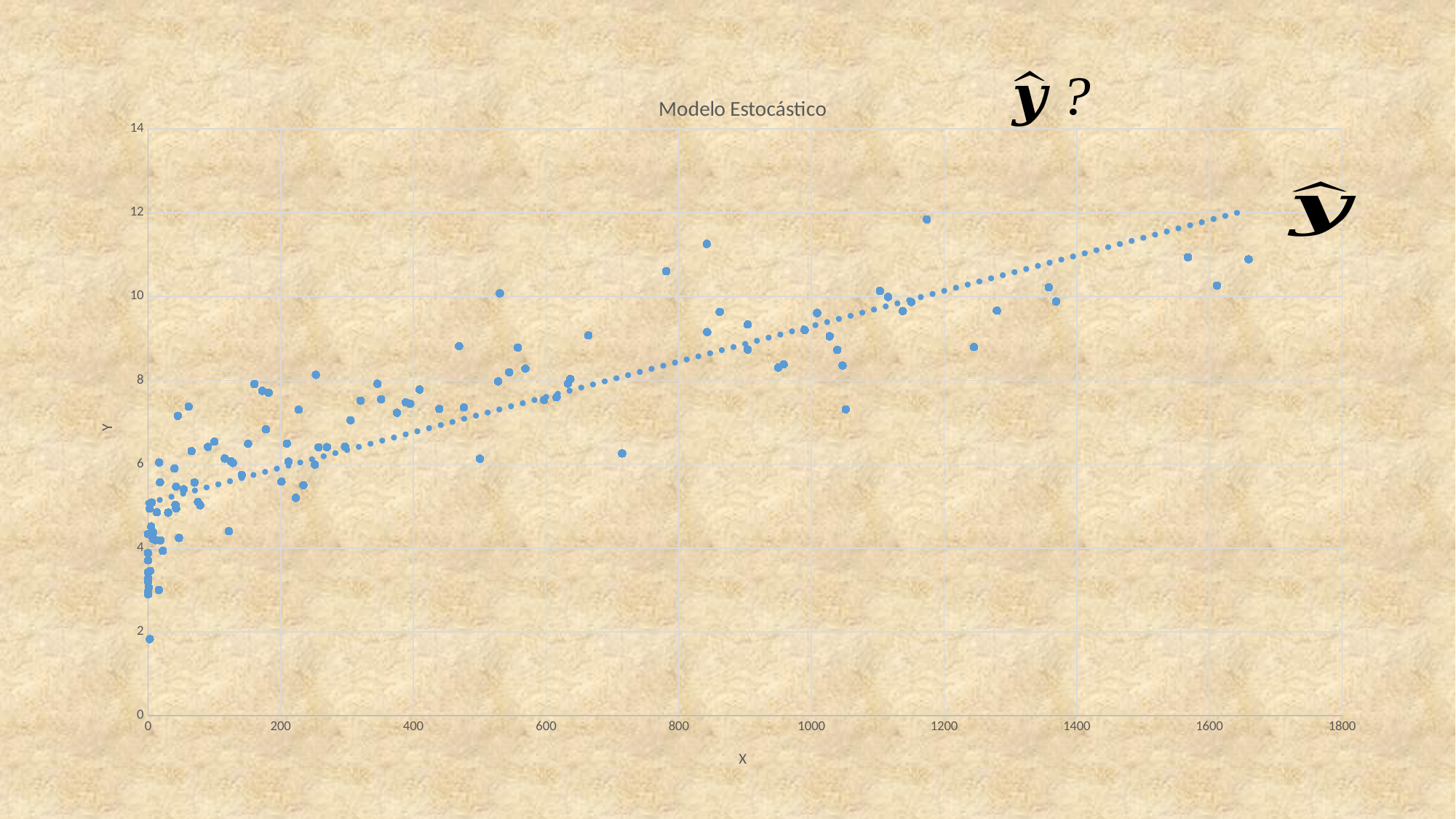
Is the value of the dotted trend line at X = 1600 greater or less than 10? greater What kind of chart is shown on the slide? scatter chart Is the dotted trend line higher at X = 200 or at X = 1600? X = 1600 Is the value of the dotted trend line at X = 0 greater or less than 6? less Is the highest plotted point on the chart greater or less than 10 on the Y axis? greater What is the title of the chart? Modelo Estocástico Do the plotted Y values generally rise or fall as X increases? rise What are the labels of the horizontal and vertical axes of the chart? X and Y